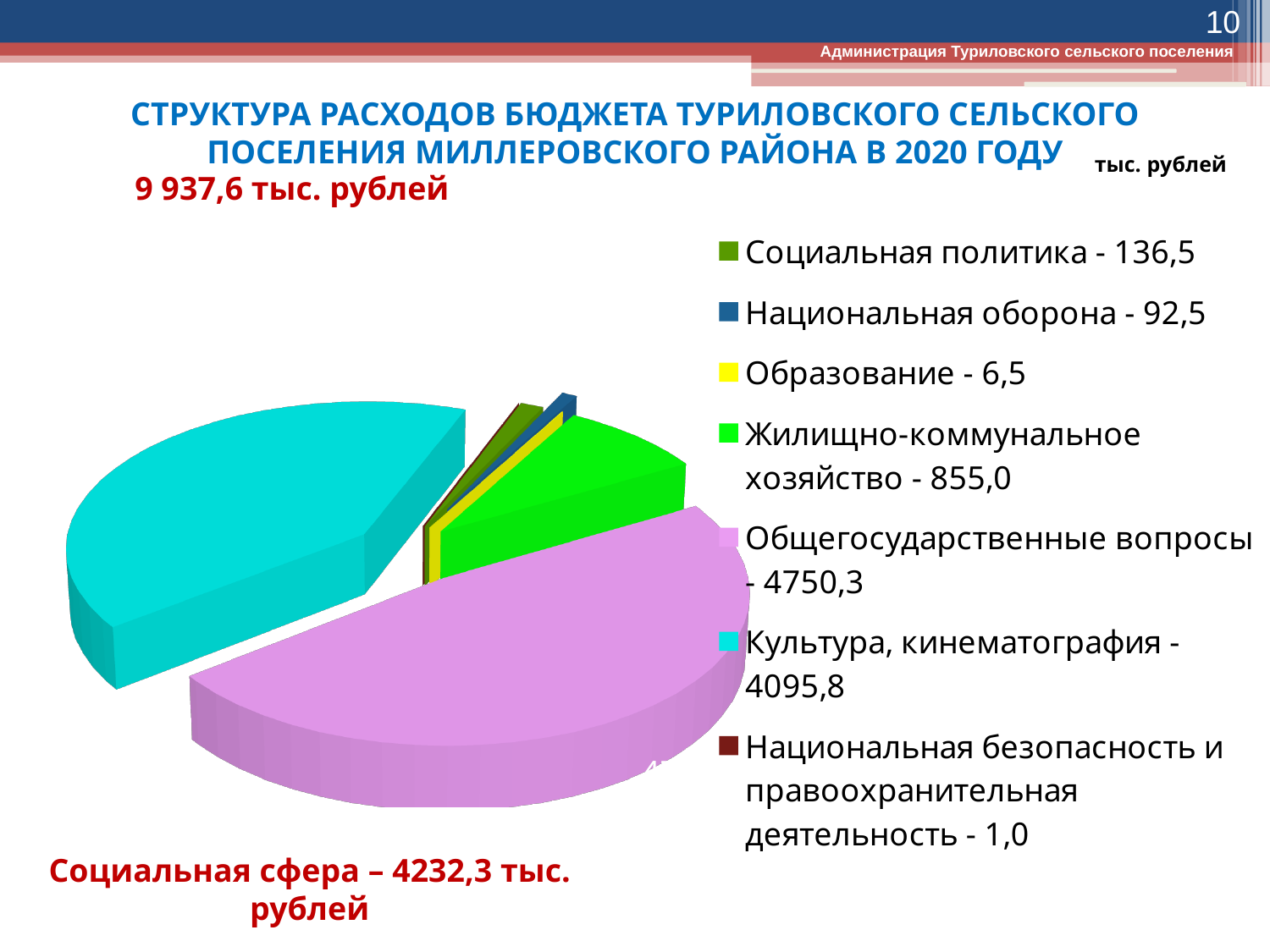
Which is larger: Социальная политика or Национальная оборона? Социальная политика What colour is the slice for Культура, кинематография? Cyan (turquoise) What is the value for Культура, кинематография? 4095,8 What is the difference between the values for Общегосударственные вопросы and Культура, кинематография? 654,5 Which category has the largest value in the pie chart? Общегосударственные вопросы Which category has the smallest value in the pie chart? Национальная безопасность и правоохранительная деятельность How many categories does the pie chart legend list? 7 What is the value for Национальная оборона? 92,5 What is the value for Жилищно-коммунальное хозяйство? 855,0 What is the value for Общегосударственные вопросы? 4750,3 What total amount of budget expenditure is stated on the slide? 9 937,6 тыс. рублей What kind of chart is shown on the slide? Pie chart